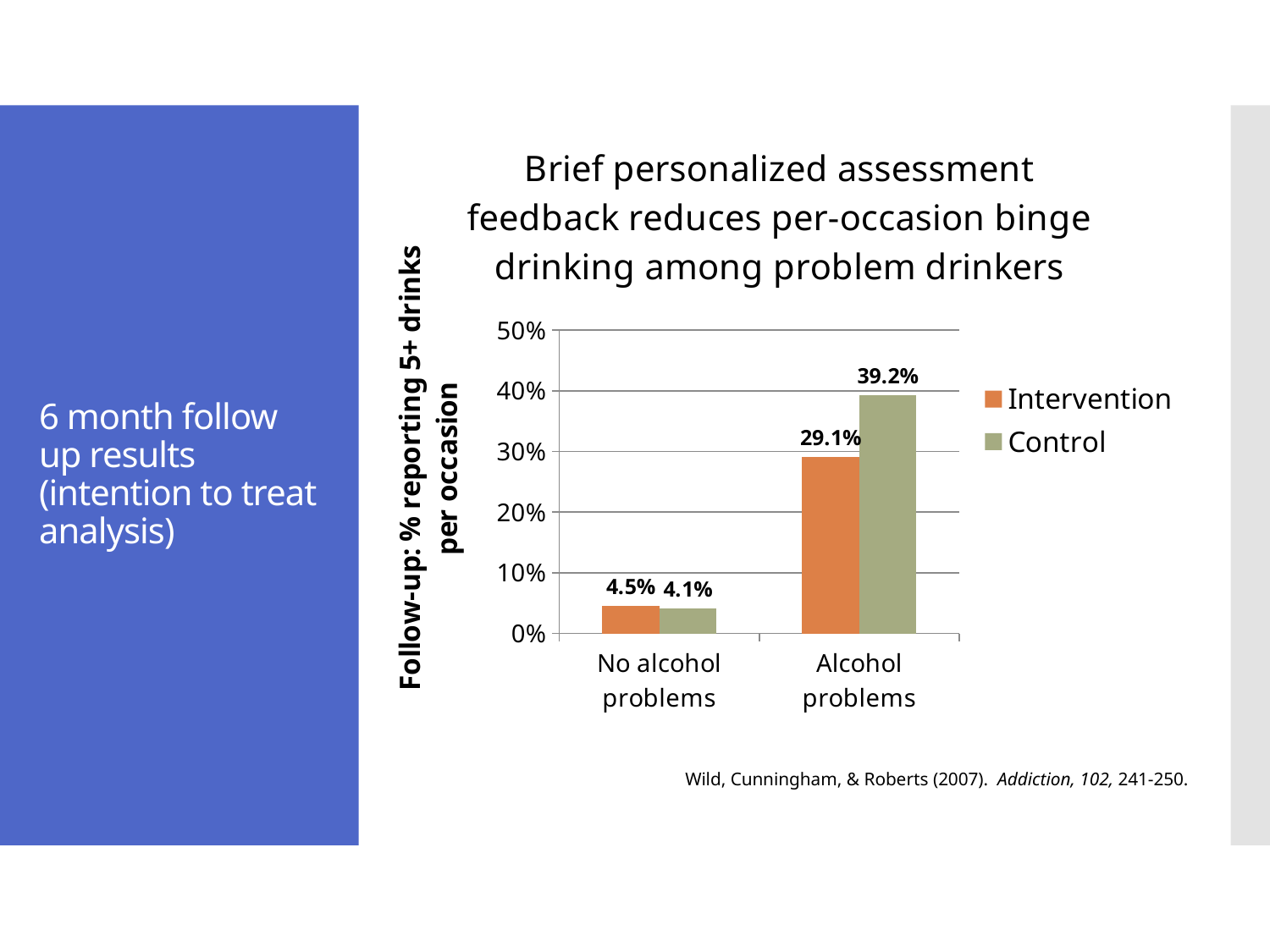
What is the Intervention value for the No alcohol problems group? 4.5% What is the Intervention value for the Alcohol problems group? 29.1% What is the Control value for the Alcohol problems group? 39.2% For the Alcohol problems group, which is larger: the Intervention value or the Control value? Control How many series does the legend list? 2 Is the Control value for the Alcohol problems group greater or less than 30%? greater What is the difference between the Control and Intervention values for the Alcohol problems group? 10.1% What is the label of the vertical axis? Follow-up: % reporting 5+ drinks per occasion Which bar has the highest value on the chart? Control, Alcohol problems How many categories are shown on the x axis? 2 What is the Control value for the No alcohol problems group? 4.1% What kind of chart is shown on the slide? Bar chart